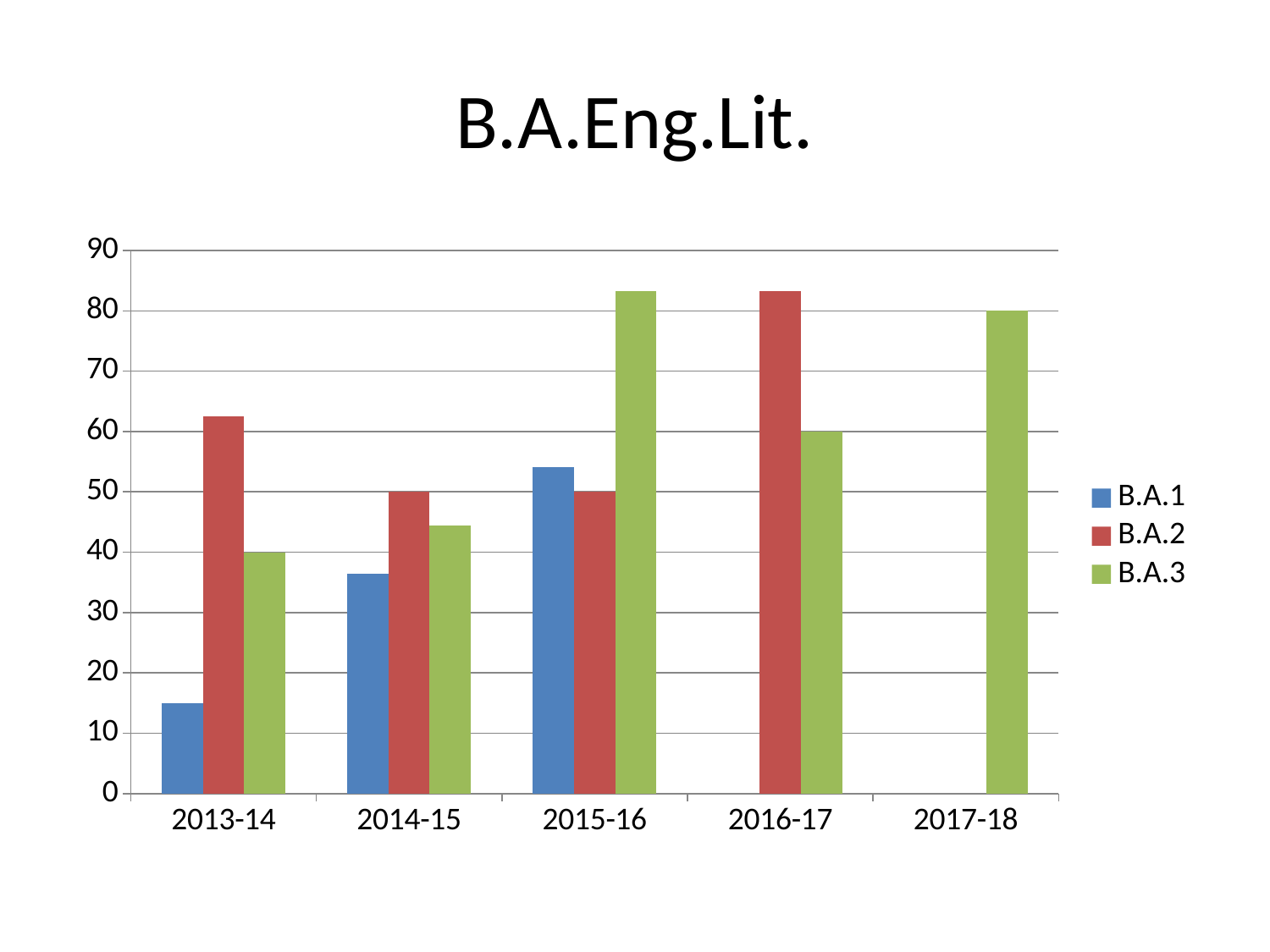
Is the value for B.A.1 in 2013-14 greater or less than 20? less What is the value for B.A.3 in 2017-18? 80 In 2013-14, which is larger, B.A.2 or B.A.3? B.A.2 What is the value for B.A.2 in 2014-15? 50 What kind of chart is shown on the slide? bar chart Is the value for B.A.2 in 2016-17 greater or less than 80? greater In which year is the B.A.1 value highest? 2015-16 Is the value for B.A.3 in 2015-16 greater or less than 80? greater How many academic years are shown on the x axis? 5 What is the title of the chart? B.A.Eng.Lit. Do the B.A.1 values rise or fall from 2013-14 to 2015-16? rise How many series does the legend list? 3